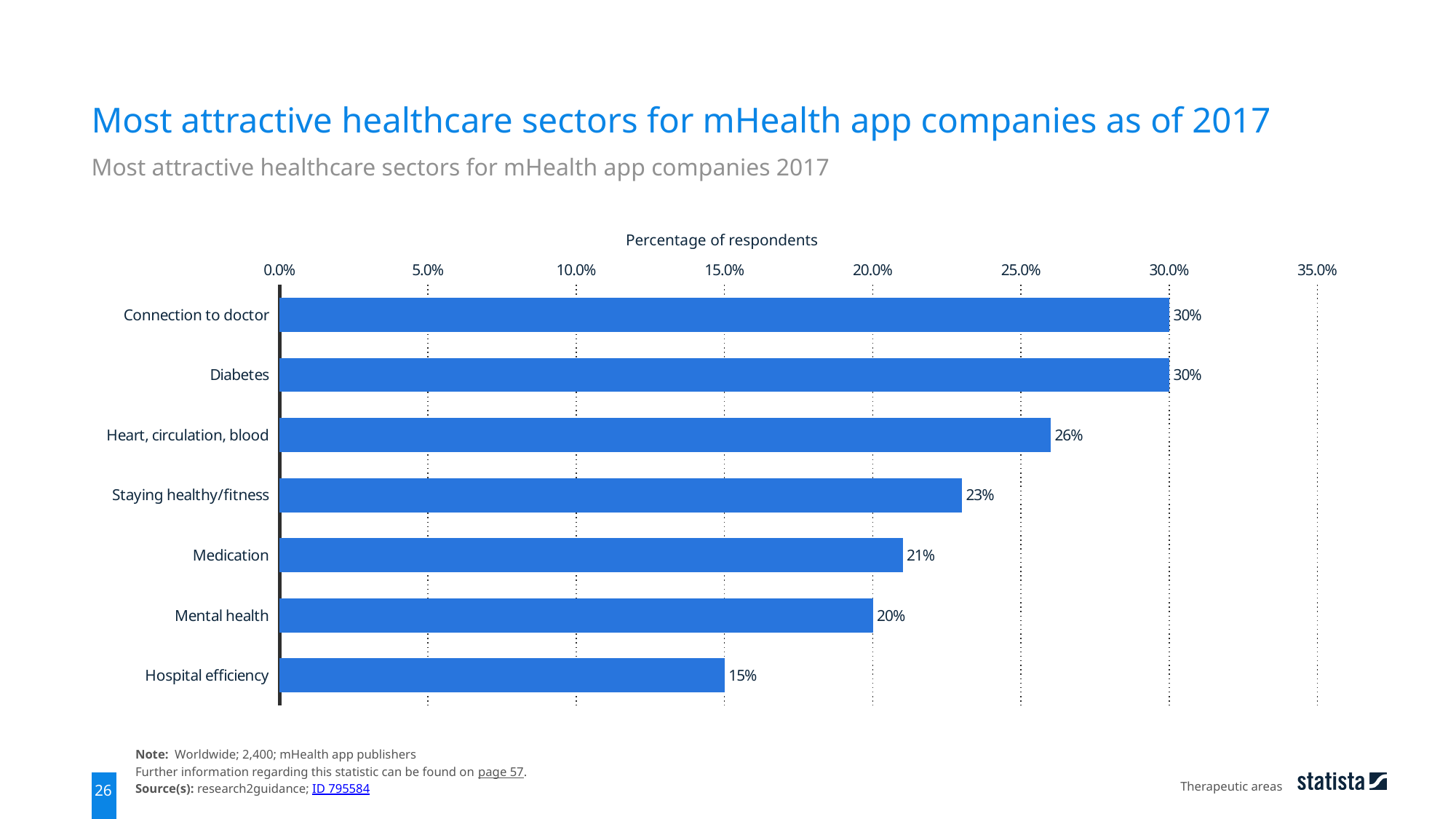
Which healthcare sector has the lowest percentage of respondents? Hospital efficiency Which has a higher value, Heart, circulation, blood or Mental health? Heart, circulation, blood What is the difference between the values for Connection to doctor and Hospital efficiency? 15% What type of chart is shown on the slide? Bar chart How many healthcare sectors are shown in the chart? 7 What is the value shown for Hospital efficiency? 15% What is the label of the horizontal axis? Percentage of respondents What percentage of respondents chose Heart, circulation, blood as an attractive healthcare sector? 26% What is the highest value shown on the horizontal axis? 35.0% What is the difference between the values for Staying healthy/fitness and Medication? 2% What percentage of respondents is shown for Mental health? 20% Is the value for Medication greater or less than 25.0%? less